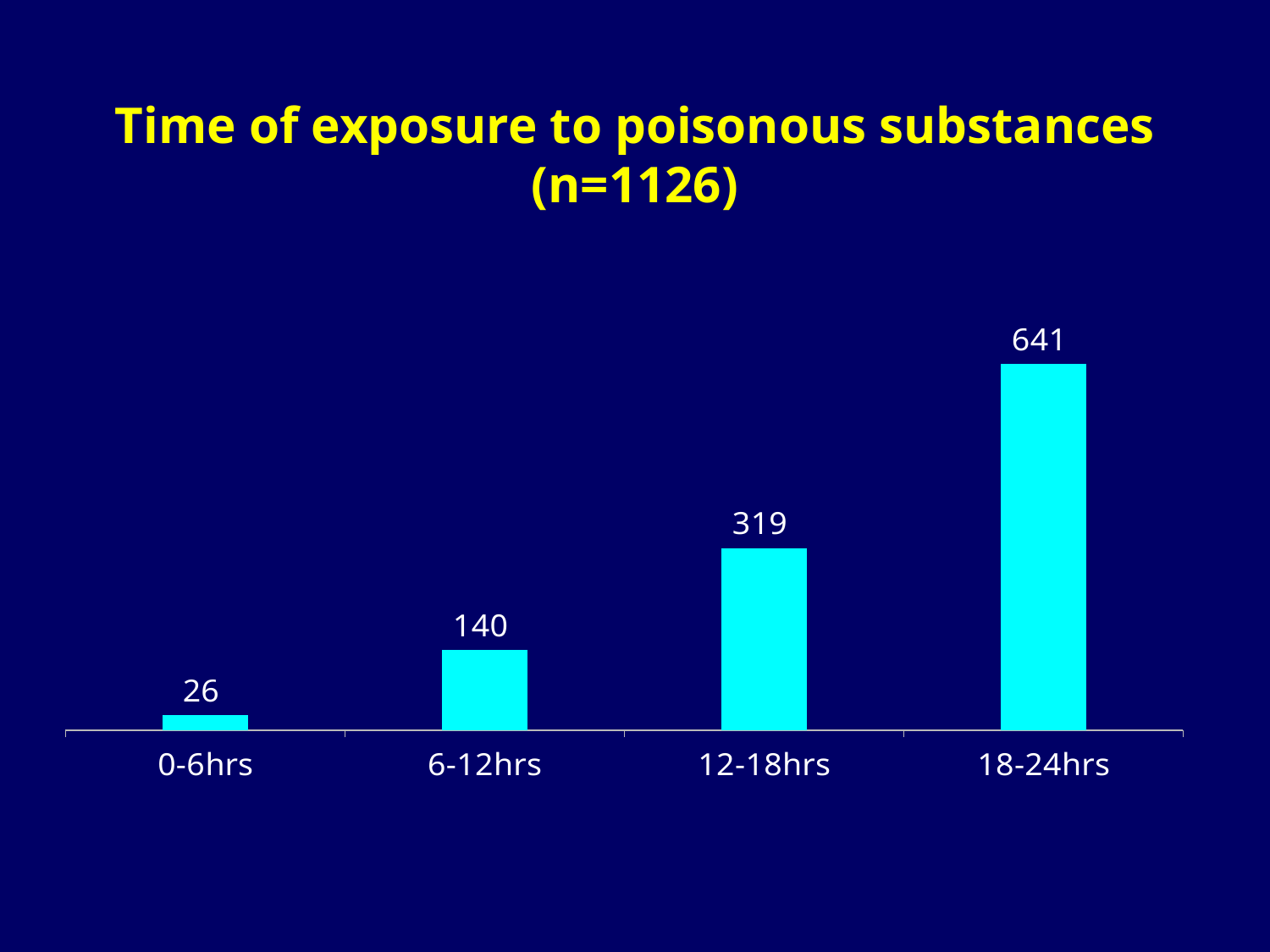
What is the difference between the values for 18-24hrs and 12-18hrs? 322 What is the value for 18-24hrs? 641 What kind of chart is shown on the slide? Bar chart What is the value for 0-6hrs? 26 What is the value for 12-18hrs? 319 How many time categories are shown on the chart? 4 Do the values rise or fall from 0-6hrs to 18-24hrs? Rise What is the difference between the values for 6-12hrs and 0-6hrs? 114 Which time category has the highest value? 18-24hrs Which is larger, the value for 12-18hrs or the value for 6-12hrs? 12-18hrs Which time category has the lowest value? 0-6hrs What is the value for 6-12hrs? 140